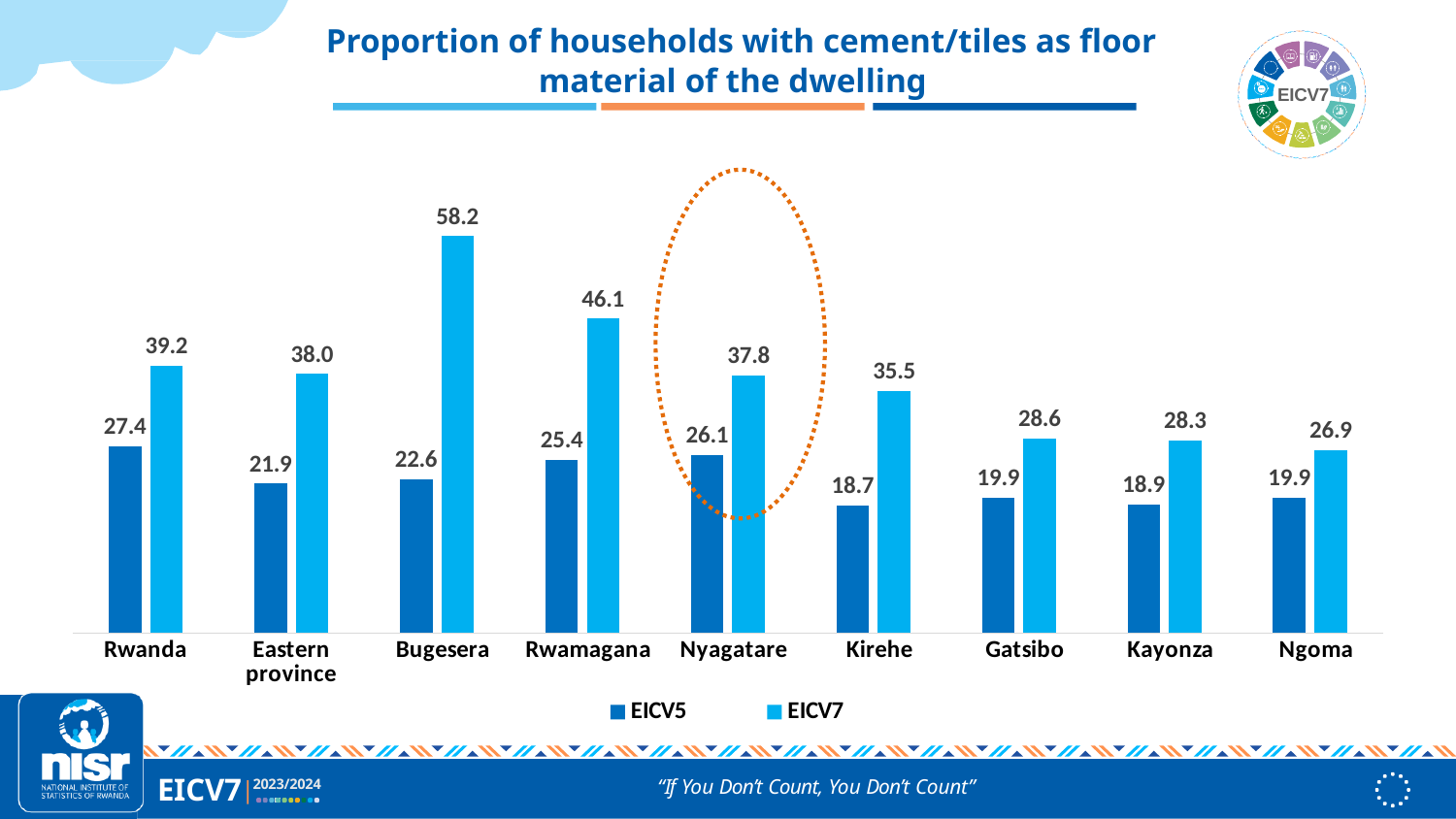
Which category has the highest EICV7 value? Bugesera What is the EICV7 value for Kirehe? 35.5 Which is larger, the EICV7 value for Rwamagana or the EICV7 value for Nyagatare? Rwamagana What is the EICV5 value for Eastern province? 21.9 What is the EICV7 value for Bugesera? 58.2 How many series does the legend list? 2 Which category is highlighted with a dotted orange oval? Nyagatare What is the EICV5 value for Nyagatare? 26.1 What is the difference between the EICV7 and EICV5 values for Rwanda? 11.8 How many categories are shown on the x axis? 9 What kind of chart is shown on the slide? Bar chart Which category has the lowest EICV5 value? Kirehe